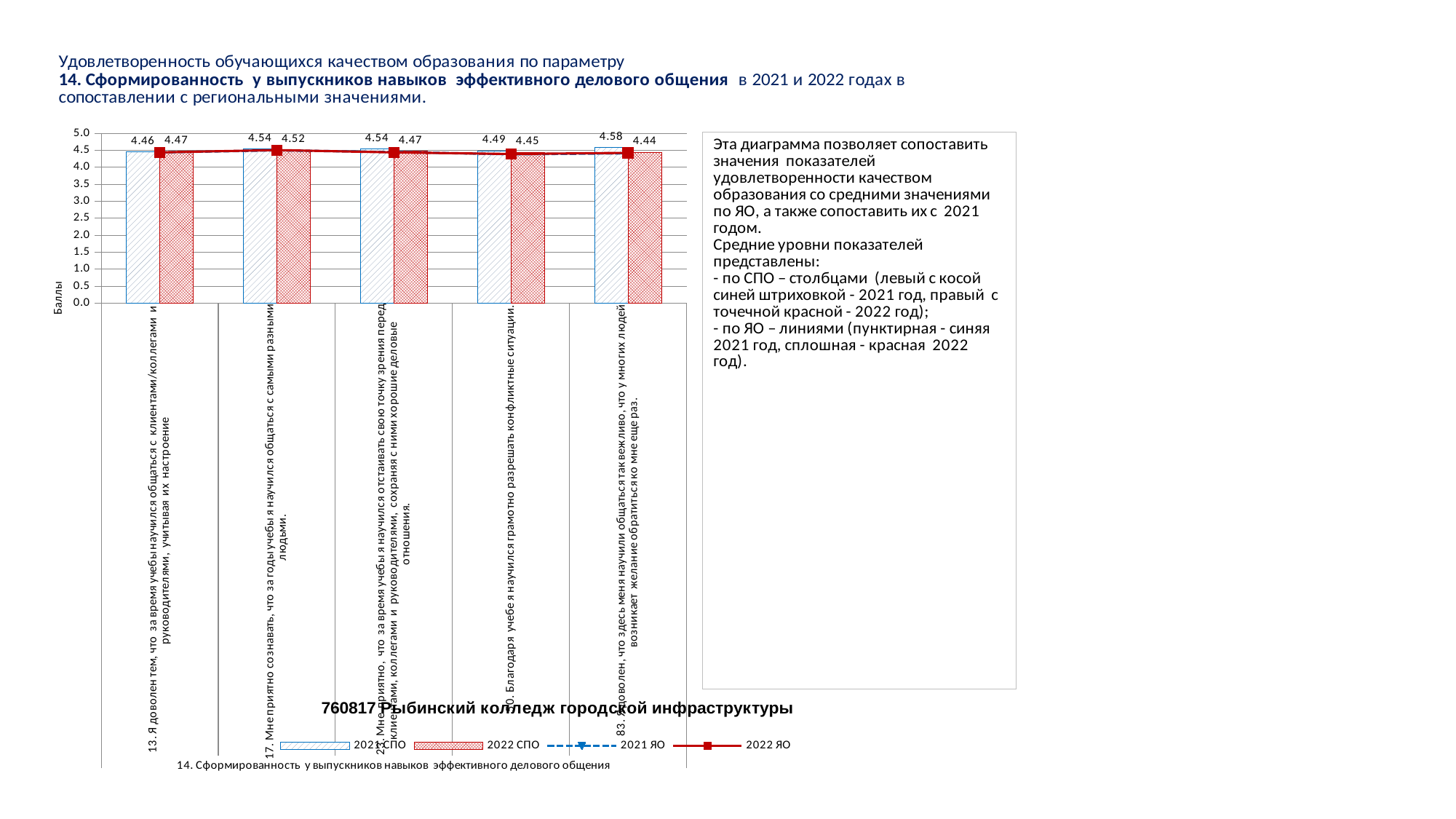
What is the 2022 СПО value for item 83 (Я доволен, что здесь меня научили общаться так вежливо)? 4.44 Is the 2021 СПО value for item 23 greater or less than 4.0? greater What kind of chart is shown on the slide? A bar chart combined with line series What is the difference between the 2021 СПО and 2022 СПО values for item 83? 0.14 How many series does the chart legend list? 4 For item 17 (Мне приятно сознавать, что за годы учебы я научился общаться с самыми разными людьми), which is larger: the 2021 СПО or the 2022 СПО value? 2021 СПО How many items (categories) are shown on the x axis of the chart? 5 What is the title of the vertical axis of the chart? Баллы Which item has the highest 2021 СПО value? 83. Я доволен, что здесь меня научили общаться так вежливо (4.58) Which item has the lowest 2022 СПО value? 83. Я доволен, что здесь меня научили общаться так вежливо (4.44) What is the 2021 СПО value for item 13 (Я доволен тем, что за время учебы научился общаться с клиентами/коллегами и руководителями)? 4.46